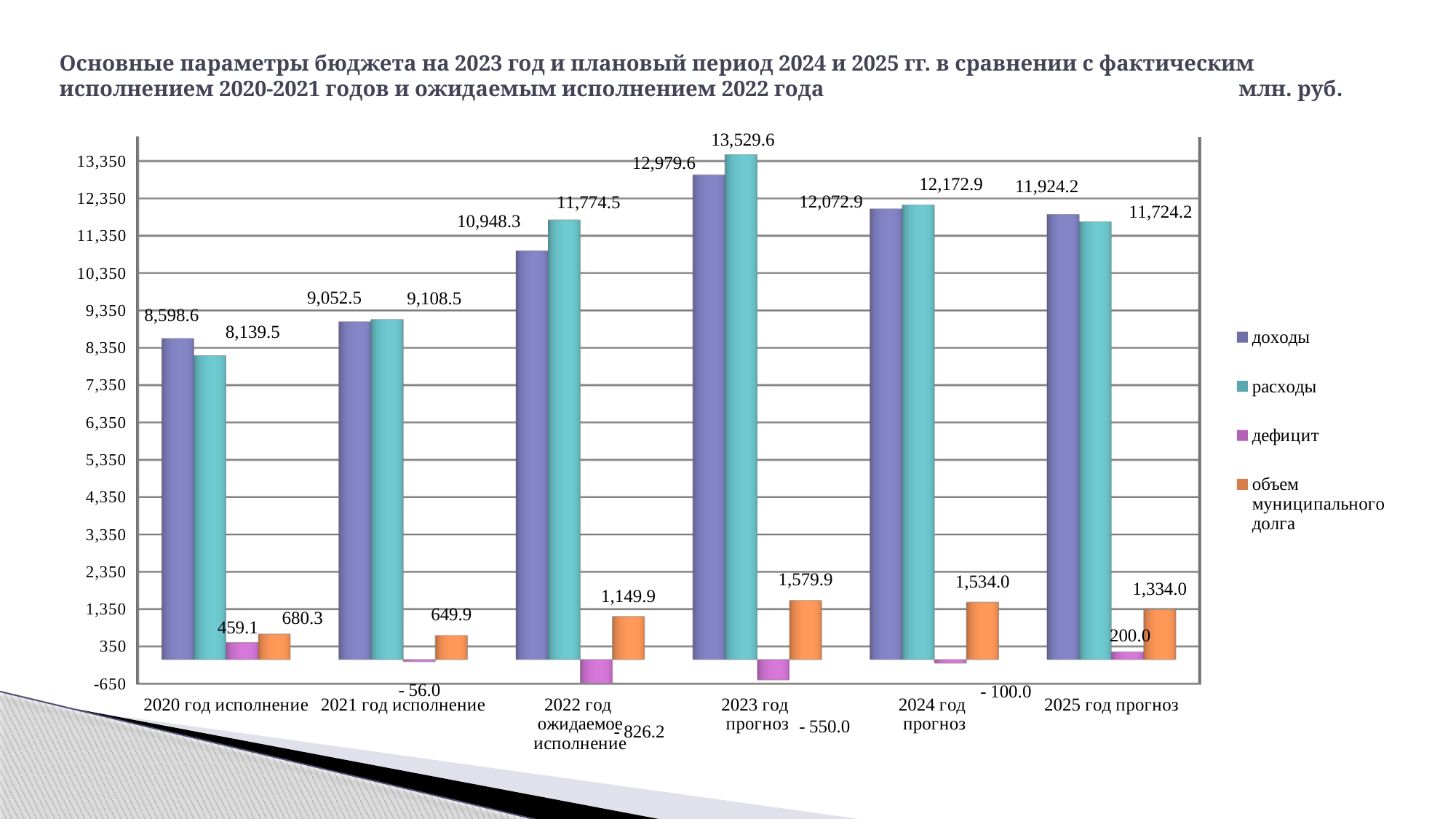
How many categories are shown on the x axis? 6 In which category is объем муниципального долга the lowest? 2021 год исполнение What is the value of дефицит for 2024 год прогноз? - 100.0 In which category is расходы the highest? 2023 год прогноз What is the difference between расходы and доходы for 2023 год прогноз? 550.0 How many series does the legend list? 4 What is the value of объем муниципального долга for 2022 год ожидаемое исполнение? 1,149.9 Which is larger for 2025 год прогноз, доходы or расходы? доходы What is the value of расходы for 2023 год прогноз? 13,529.6 Does объем муниципального долга rise or fall from 2023 год прогноз to 2025 год прогноз? fall What kind of chart is shown on the slide? bar chart What is the value of доходы for 2020 год исполнение? 8,598.6